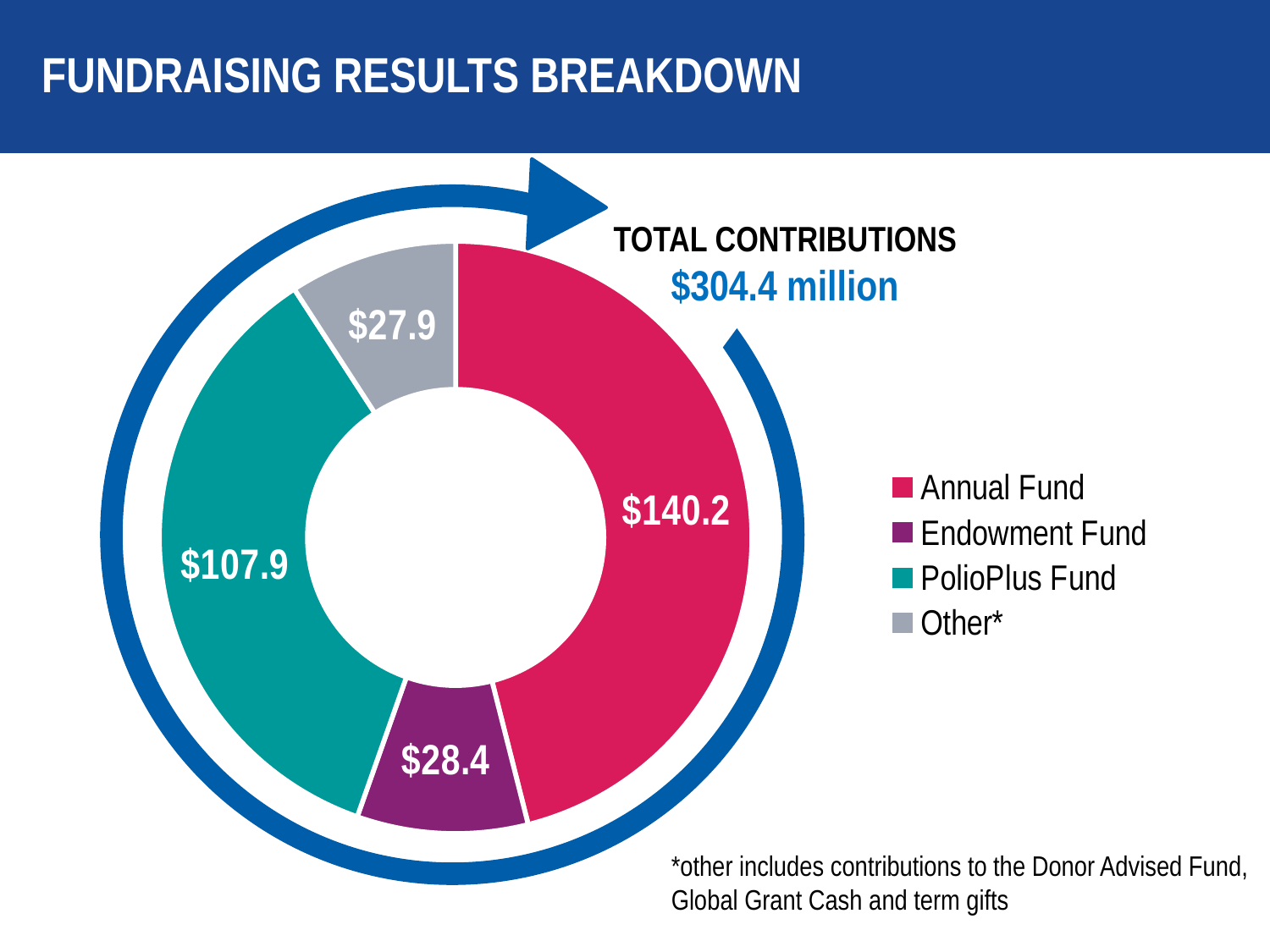
What total contributions figure is stated next to the chart? $304.4 million What is the difference between the Annual Fund and the PolioPlus Fund values? $32.3 What colour represents the PolioPlus Fund in the legend? Teal (green) Which is larger, the Endowment Fund or the Other* category? Endowment Fund What kind of chart is shown on the slide? Doughnut (pie) chart What is the value shown for the Annual Fund? $140.2 Which category has the smallest slice of the chart? Other* How many categories does the chart show? 4 What is the value shown for the Endowment Fund? $28.4 What is the value shown for the Other* category? $27.9 What is the value shown for the PolioPlus Fund? $107.9 Which fund has the largest slice of the chart? Annual Fund